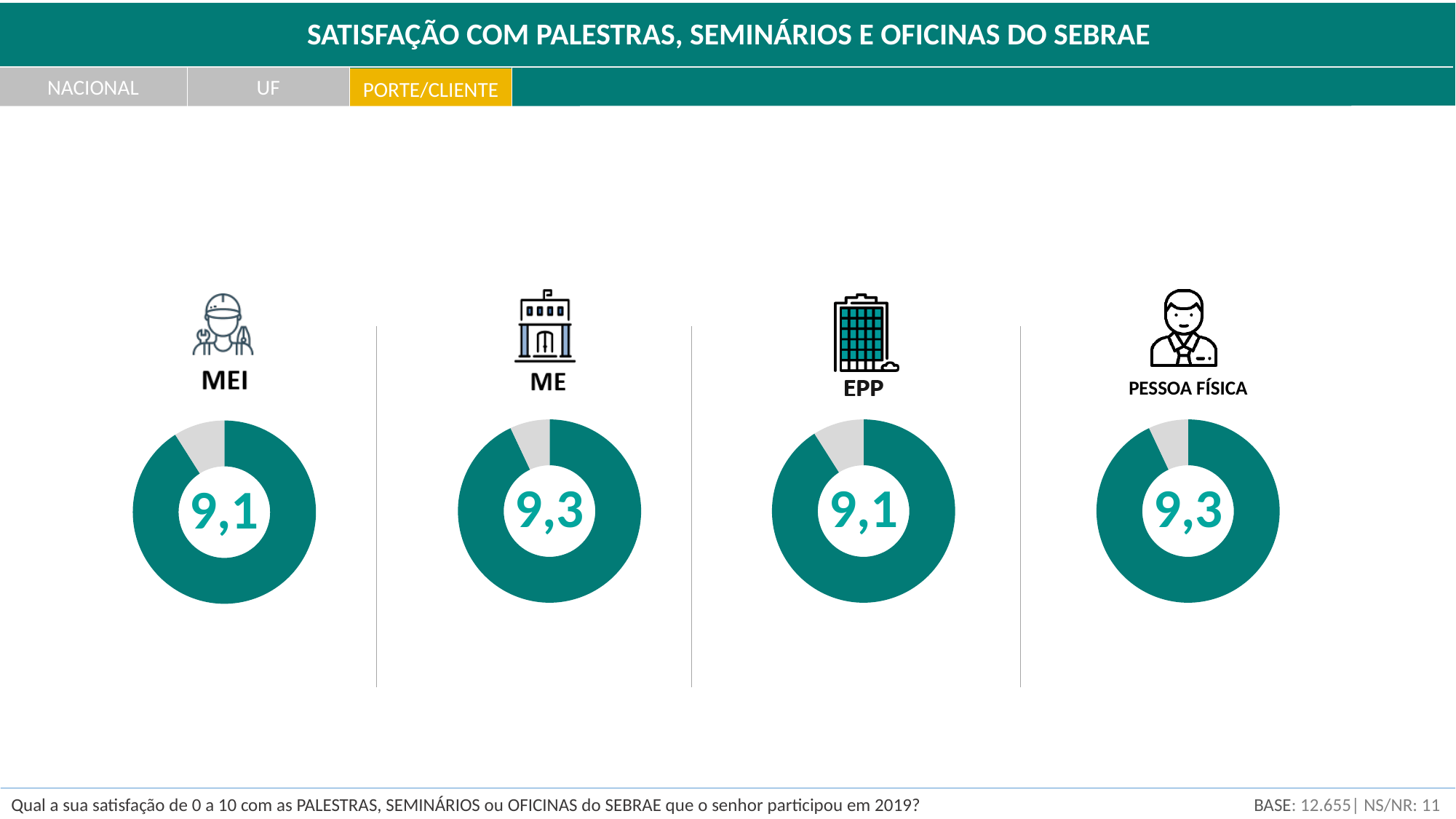
Which has the higher satisfaction score, ME or MEI? ME How many donut charts are shown on the slide? 4 What kind of chart is used to display each satisfaction score? Donut (pie) chart Which has the lower satisfaction score, EPP or PESSOA FÍSICA? EPP What is the satisfaction score shown in the ME donut chart? 9,3 Which tab is highlighted in yellow at the top of the slide? PORTE/CLIENTE What is the satisfaction score shown in the MEI donut chart? 9,1 What is the title of the slide? SATISFAÇÃO COM PALESTRAS, SEMINÁRIOS E OFICINAS DO SEBRAE What is the difference between the ME score and the MEI score? 0,2 What is the satisfaction score shown in the EPP donut chart? 9,1 What is the difference between the PESSOA FÍSICA score and the EPP score? 0,2 What is the satisfaction score shown in the PESSOA FÍSICA donut chart? 9,3